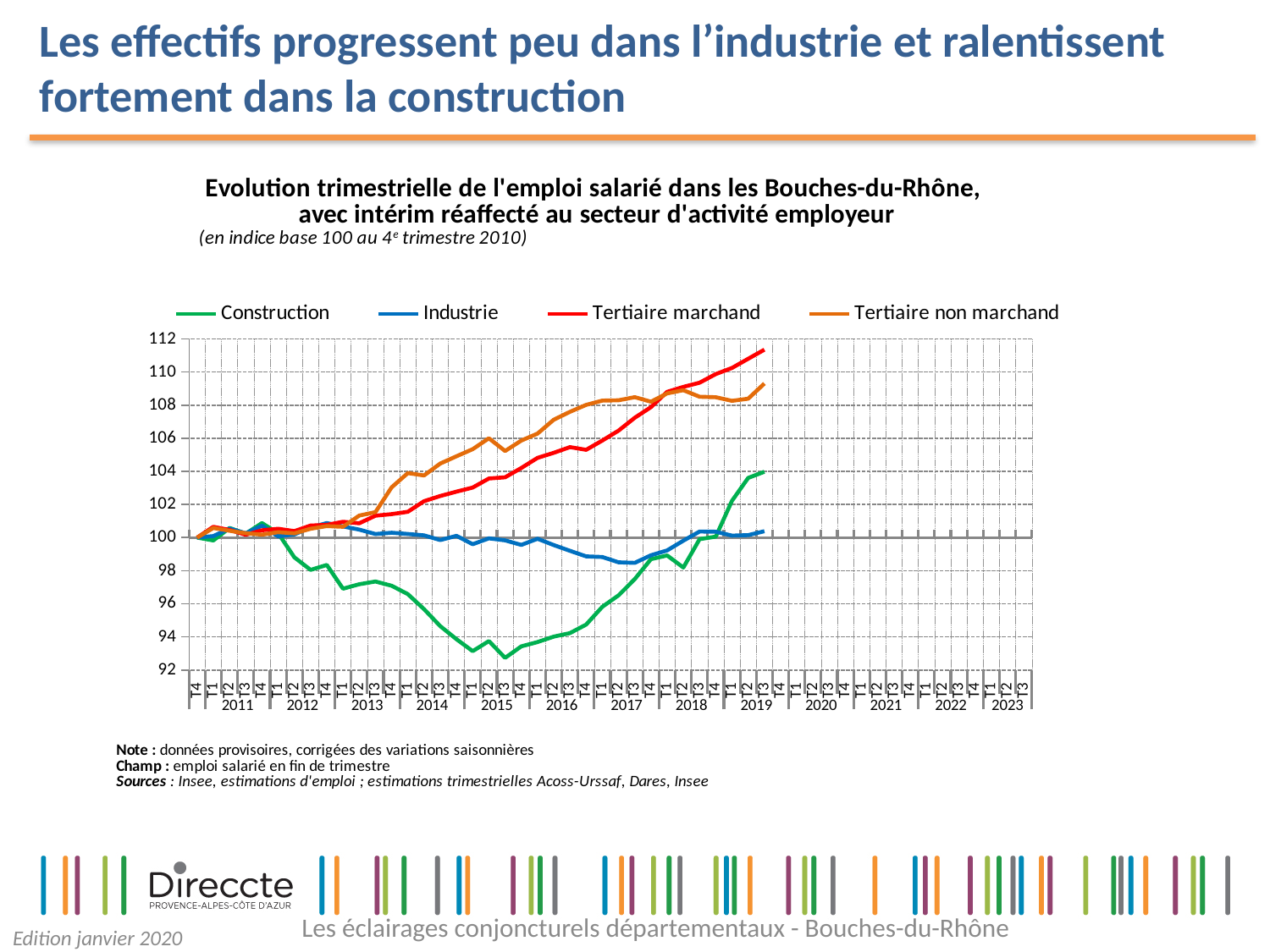
Does the Tertiaire marchand series rise or fall from 2013 to 2019? rise What kind of chart is shown on the slide? line chart How many series does the legend list? 4 Which series has the lowest value at T1 2015? Construction Is the value for Industrie at T4 2017 greater or less than 100? less At T3 2019, which is higher: Construction or Industrie? Construction Is the value for Construction at T1 2015 greater or less than 94? less Which series has the highest value at T3 2019? Tertiaire marchand Does the Construction series rise or fall between 2011 and T1 2015? fall What is the base value of the index, and at which quarter? 100 at the 4th quarter of 2010 Is the value for Tertiaire marchand at T3 2019 greater or less than 110? greater Which series is plotted in green? Construction